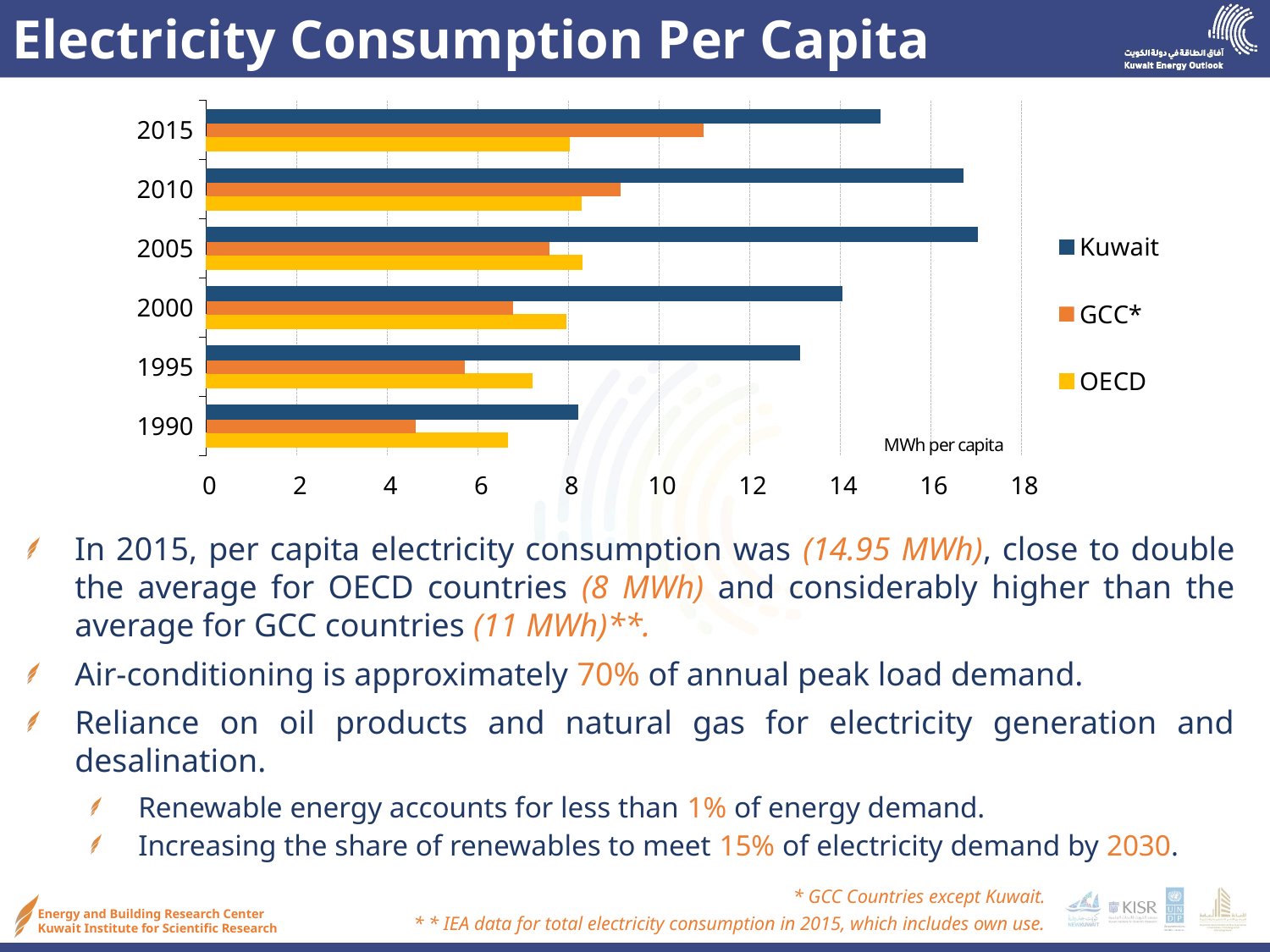
Is the GCC* value for 1990 greater or less than 4? greater Do the GCC* values rise or fall from 1990 to 2015? rise How many years are shown on the chart? 6 Is the OECD value for 1995 greater or less than 8? less In 2015, which is larger, the Kuwait value or the GCC* value? Kuwait What kind of chart is shown on the slide? bar chart Is the GCC* value for 2015 greater or less than 10? greater What unit is given for the values on the chart? MWh per capita How many series does the legend list? 3 In which year is the Kuwait value lowest? 1990 What is the OECD value for 2015? 8